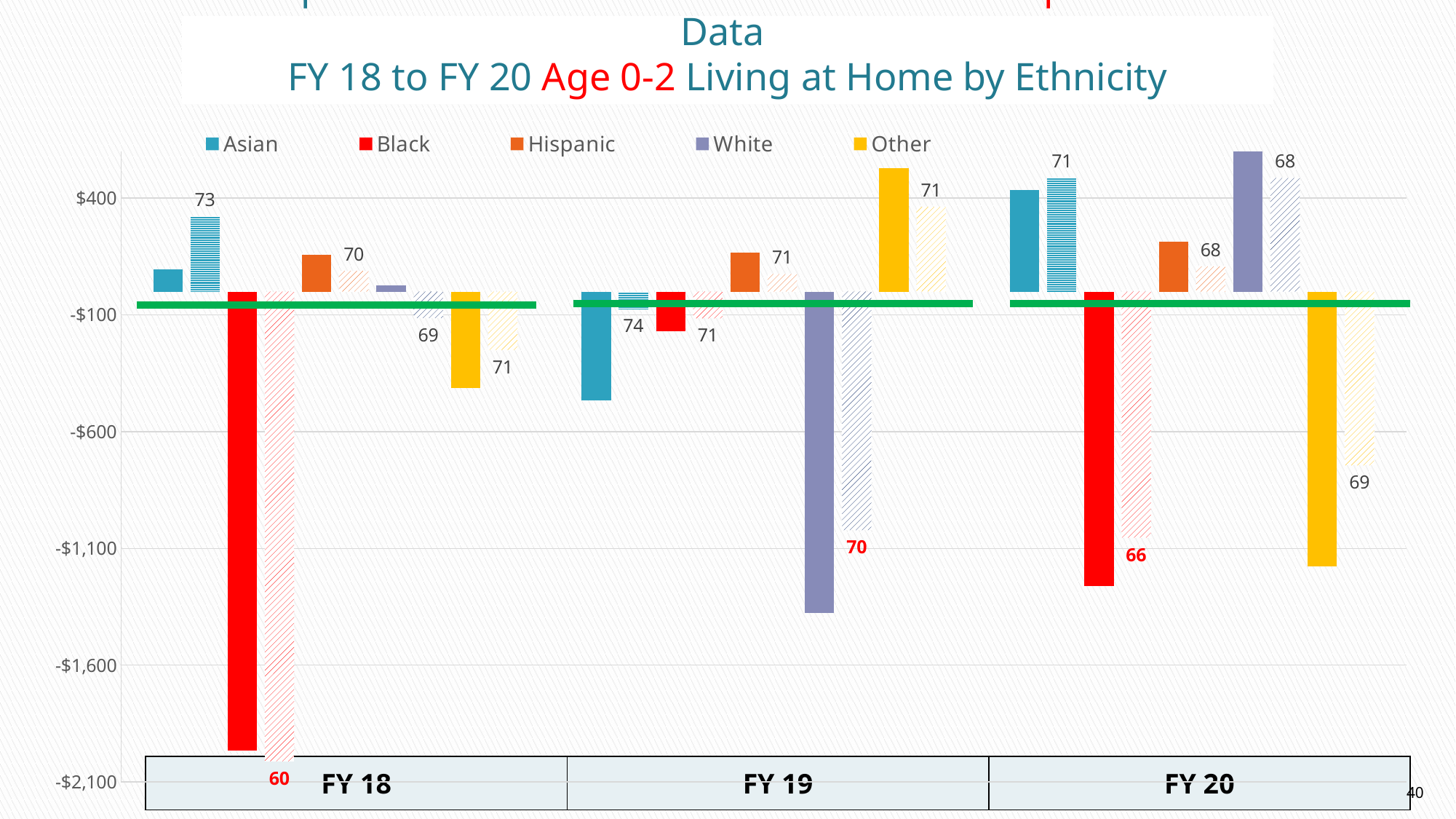
Which series has the highest bar in FY 20? White Is the value for White in FY 19 greater or less than -$1,100? less Is the value for Black in FY 18 greater or less than -$1,600? less Is the value for Asian in FY 19 greater or less than -$600? greater What colour represents the Black series in the legend? red What kind of chart is shown on the slide? bar chart How many series does the legend list? 5 How many fiscal years are shown on the x axis? 3 Which series has the lowest bar in FY 18? Black What number label is printed next to the Asian bar in FY 18? 73 Which is lower, the Black bar in FY 18 or the Black bar in FY 20? Black in FY 18